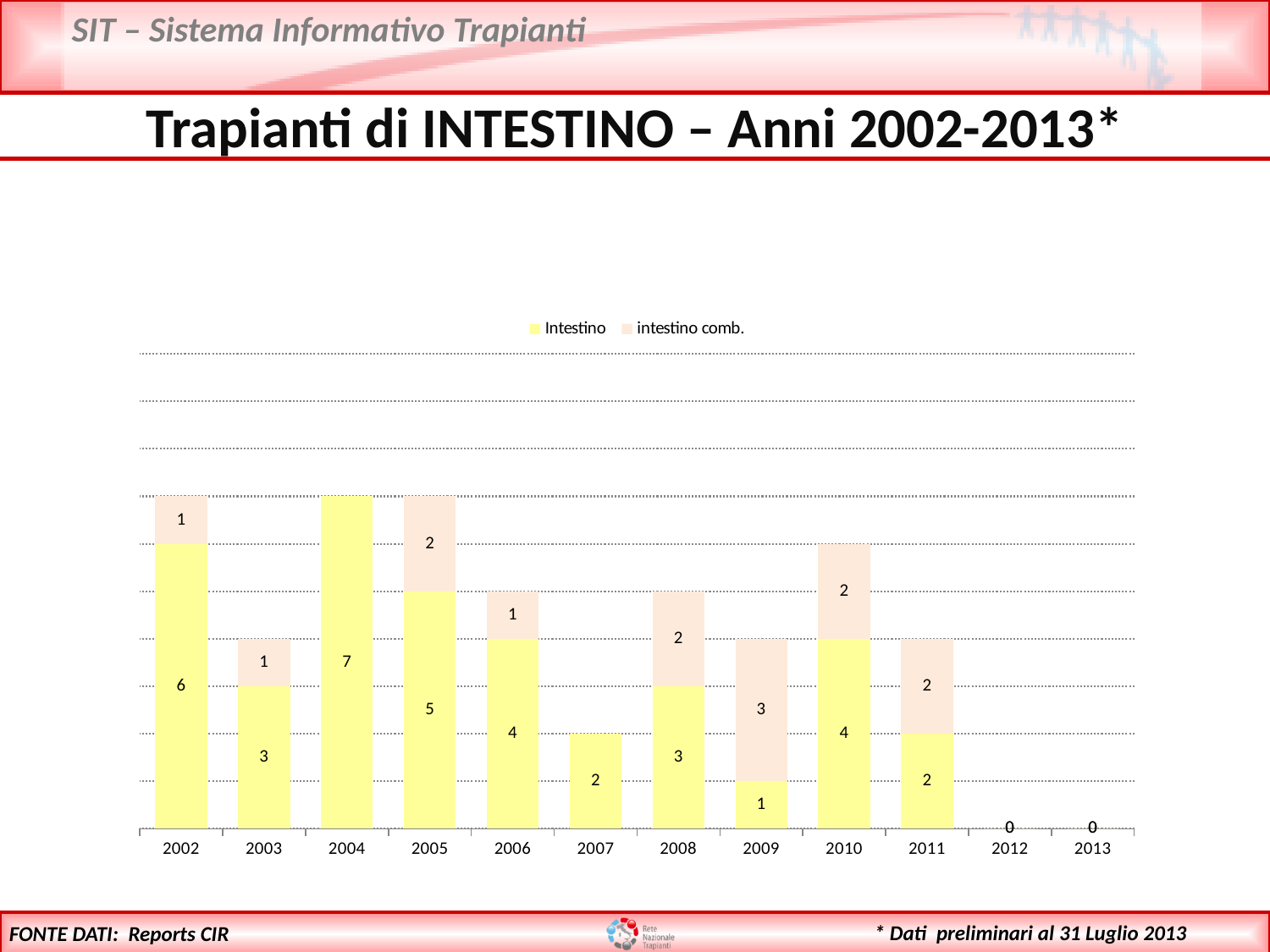
What is the total of the stacked bar for 2005? 7 Which is larger, the Intestino value for 2006 or for 2008? 2006 How many series does the legend list? 2 What is the value for Intestino in 2004? 7 What kind of chart is shown on the slide? stacked bar chart Which year has the highest value for Intestino? 2004 Which year has the highest value for intestino comb.? 2009 What is the difference between the Intestino values for 2002 and 2003? 3 What is the value for Intestino in 2002? 6 What is the value for intestino comb. in 2009? 3 What is the total of the stacked bar for 2010? 6 How many years are shown on the x axis? 12